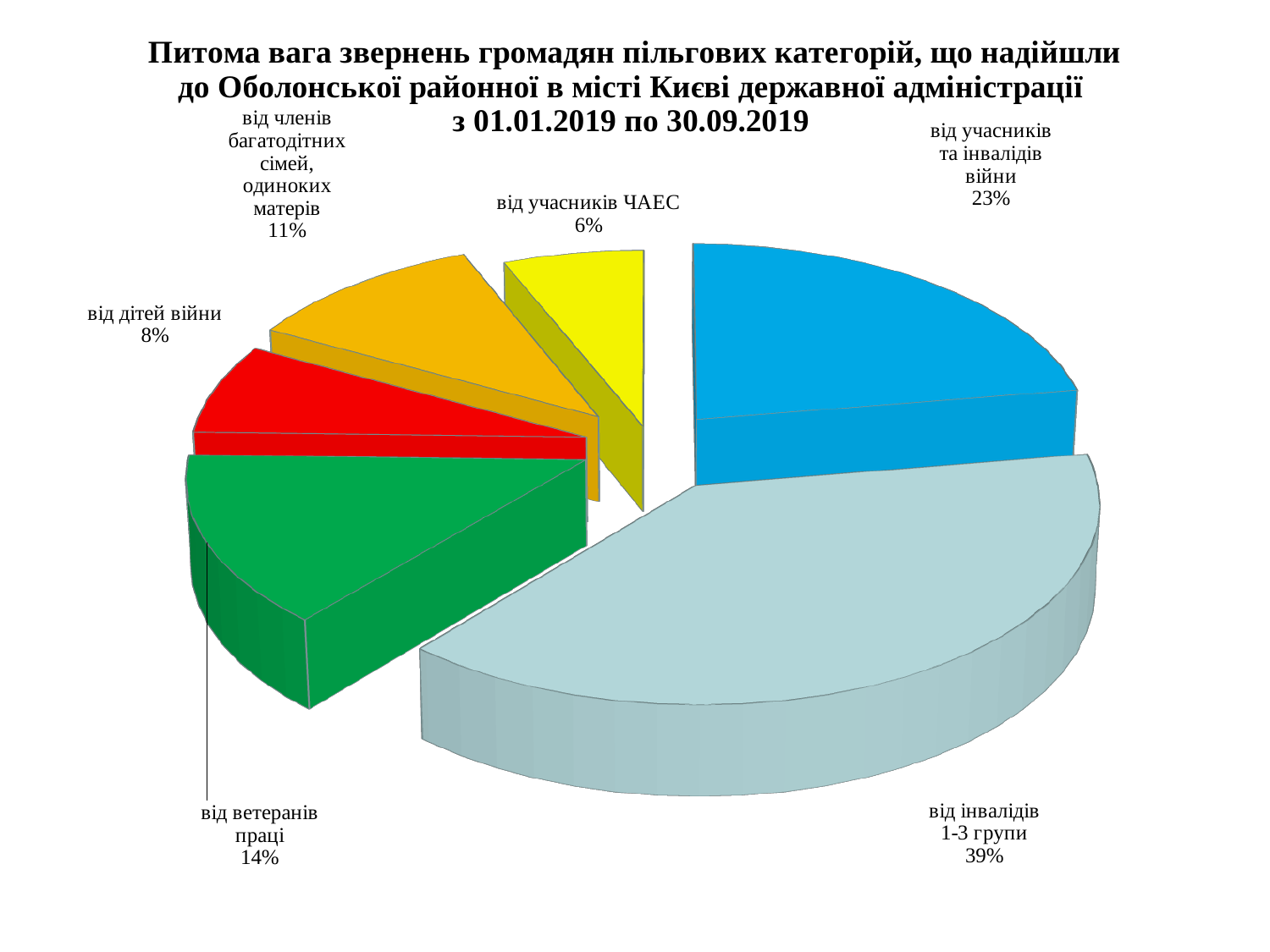
Which category has the smallest share of the pie? від учасників ЧАЕС Which category has the largest share of the pie? від інвалідів 1-3 групи How many slices does the pie chart have? 6 What kind of chart is shown on the slide? pie chart What is the difference in percentage points between 'від інвалідів 1-3 групи' and 'від учасників та інвалідів війни'? 16 Which is larger: the share for 'від членів багатодітних сімей, одиноких матерів' or the share for 'від дітей війни'? від членів багатодітних сімей, одиноких матерів What share of the pie is 'від учасників ЧАЕС'? 6% What share of the pie is 'від учасників та інвалідів війни'? 23% What share of the pie is 'від дітей війни'? 8% What period does the chart title say the data covers? з 01.01.2019 по 30.09.2019